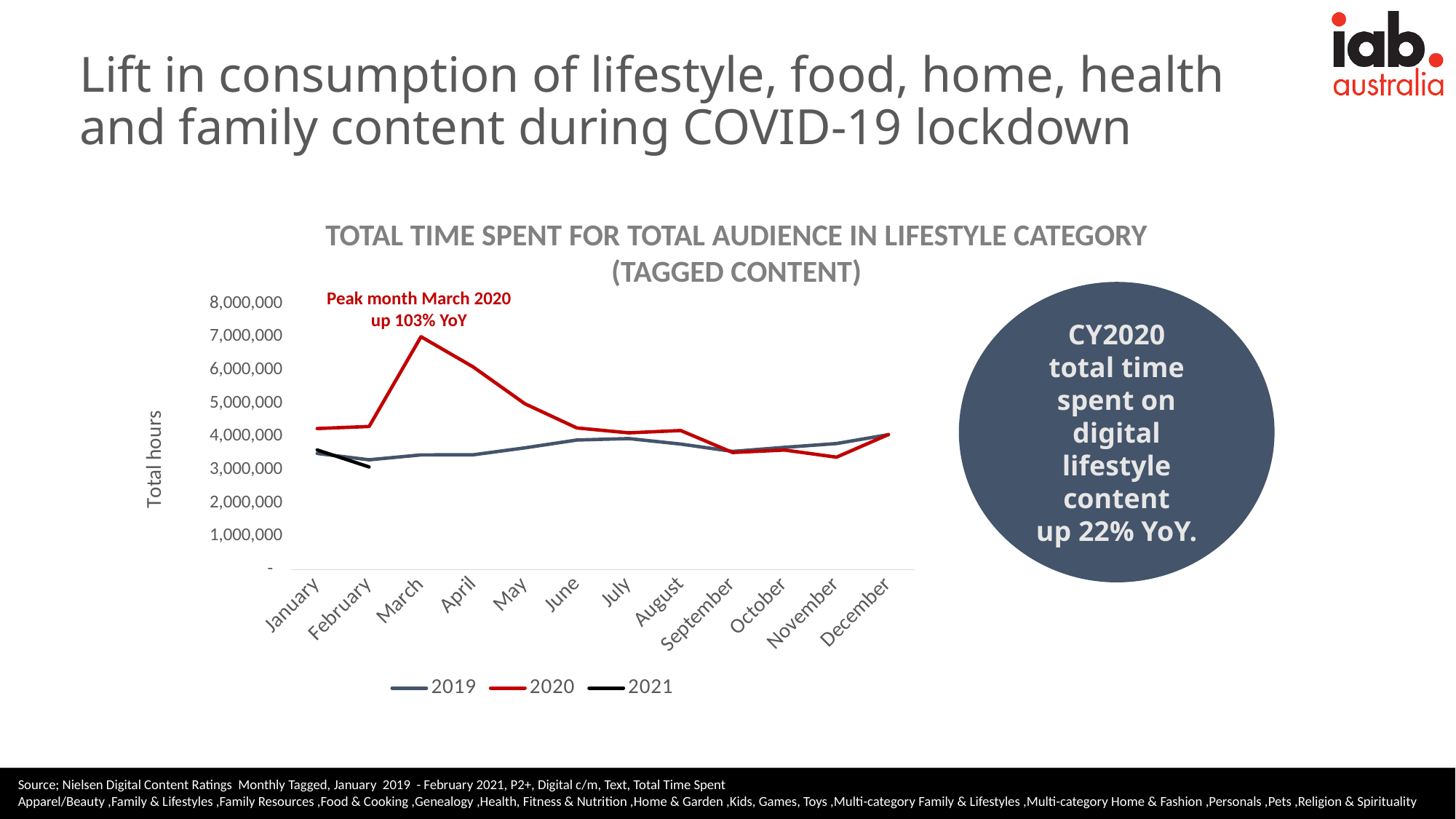
What kind of chart is shown on the slide? Line chart Which series has the larger value in November, 2019 or 2020? 2019 Is the 2020 value for November greater or less than 4,000,000? less Does the 2020 series rise or fall from March to June? fall How many series does the legend list? 3 Is the 2020 value for March greater or less than 6,000,000? greater Which series has the larger value in March, 2019 or 2020? 2020 In which month does the 2020 series reach its highest value? March Is the 2021 value for February greater or less than 4,000,000? less According to the annotation on the chart, by what percentage was the peak month March 2020 up year on year? 103% How many months are shown along the x axis? 12